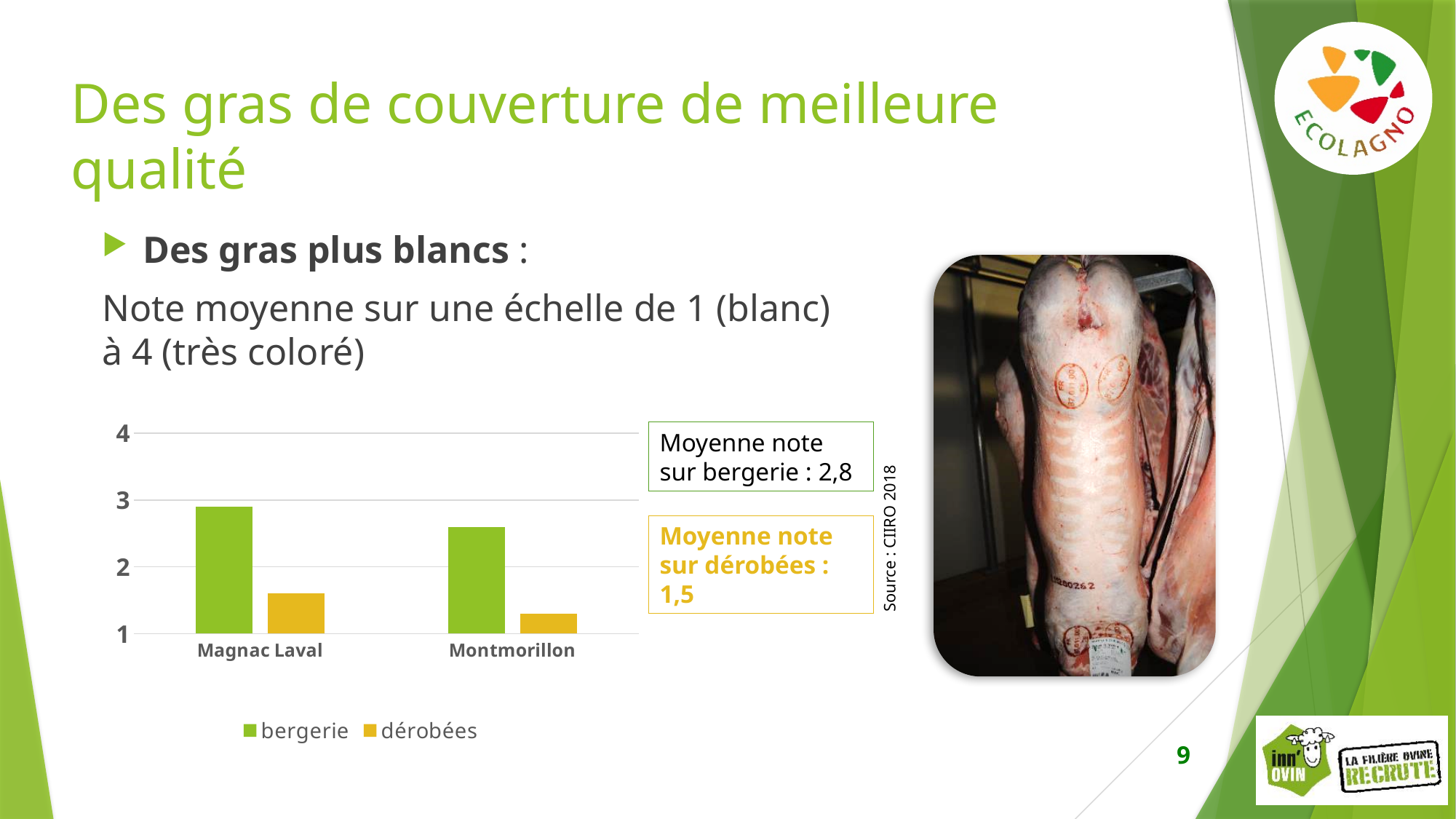
Is the dérobées value for Montmorillon greater or less than 2? less What kind of chart is shown on the slide? bar chart Is the bergerie value for Magnac Laval greater or less than 2? greater Which category has the highest bergerie bar? Magnac Laval At Magnac Laval, which series has the larger value, bergerie or dérobées? bergerie How many categories are shown on the x axis of the chart? 2 How many series does the chart legend list? 2 What colour are the dérobées bars in the chart? yellow Does the bergerie series rise or fall from Magnac Laval to Montmorillon? fall What are the two series names listed in the chart legend? bergerie, dérobées Which category has the lowest dérobées bar? Montmorillon Is the bergerie value for Montmorillon greater or less than 3? less